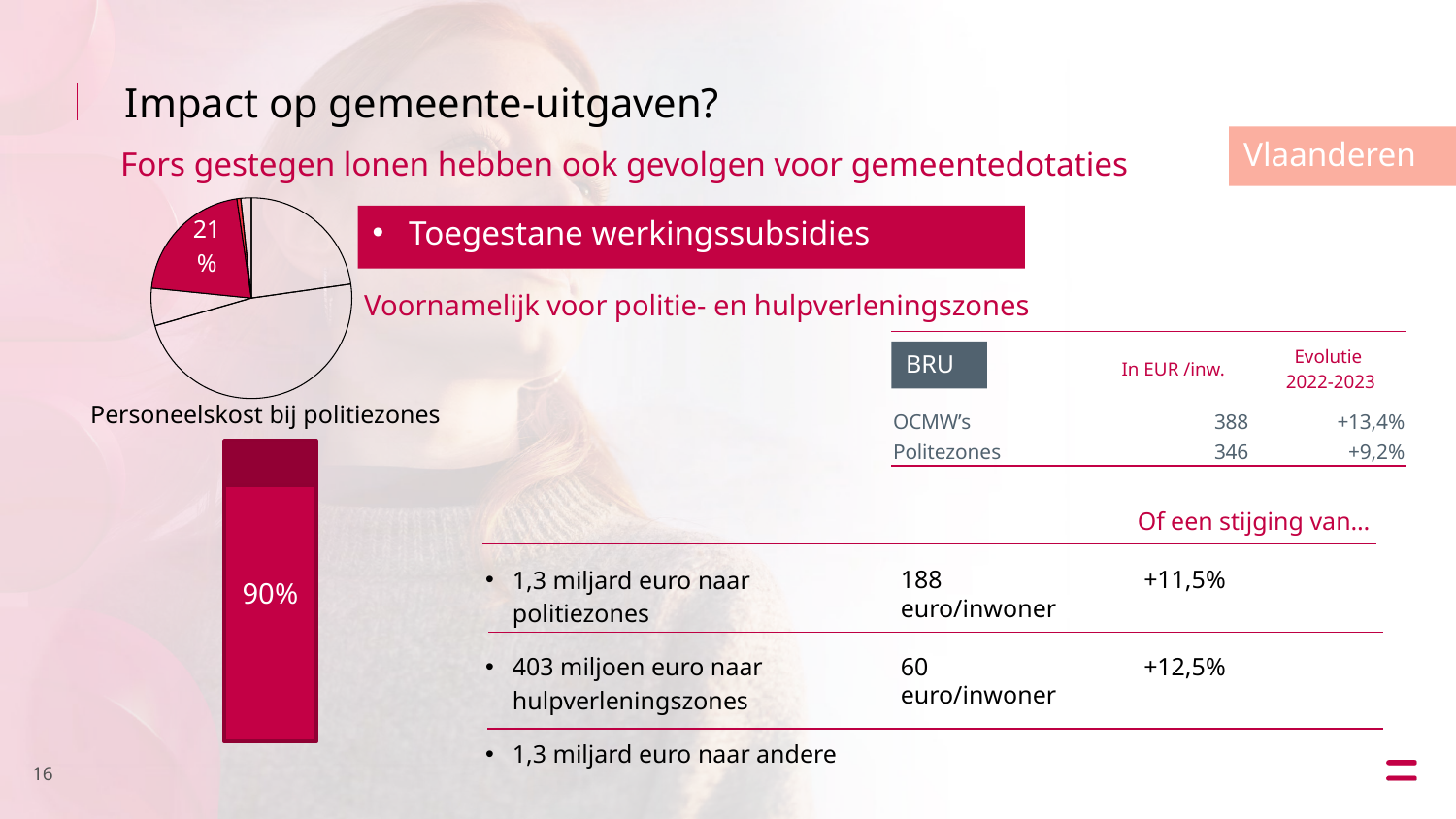
What colour is the large 90% segment of the bar in the bar chart at the bottom left? magenta/red What kind of chart is shown at the bottom left of the slide, below 'Personeelskost bij politiezones'? bar chart In the bar chart at the bottom left, how many bars are plotted? 1 In the pie chart at the top left, is the highlighted 21% slice larger or smaller than the large unlabeled slice? smaller In the pie chart at the top left, what share of the pie does the highlighted slice represent? 21% In the bar chart at the bottom left, how many segments does the bar consist of? 2 In the pie chart at the top left, what value is printed on the highlighted slice? 21% What kind of chart is shown at the top left of the slide? pie chart In the bar chart at the bottom left, what value is printed on the large segment of the bar? 90% What text appears between the pie chart and the bar chart on the left of the slide? Personeelskost bij politiezones In the bar chart at the bottom left, is the segment labeled 90% larger or smaller than the unlabeled segment above it? larger